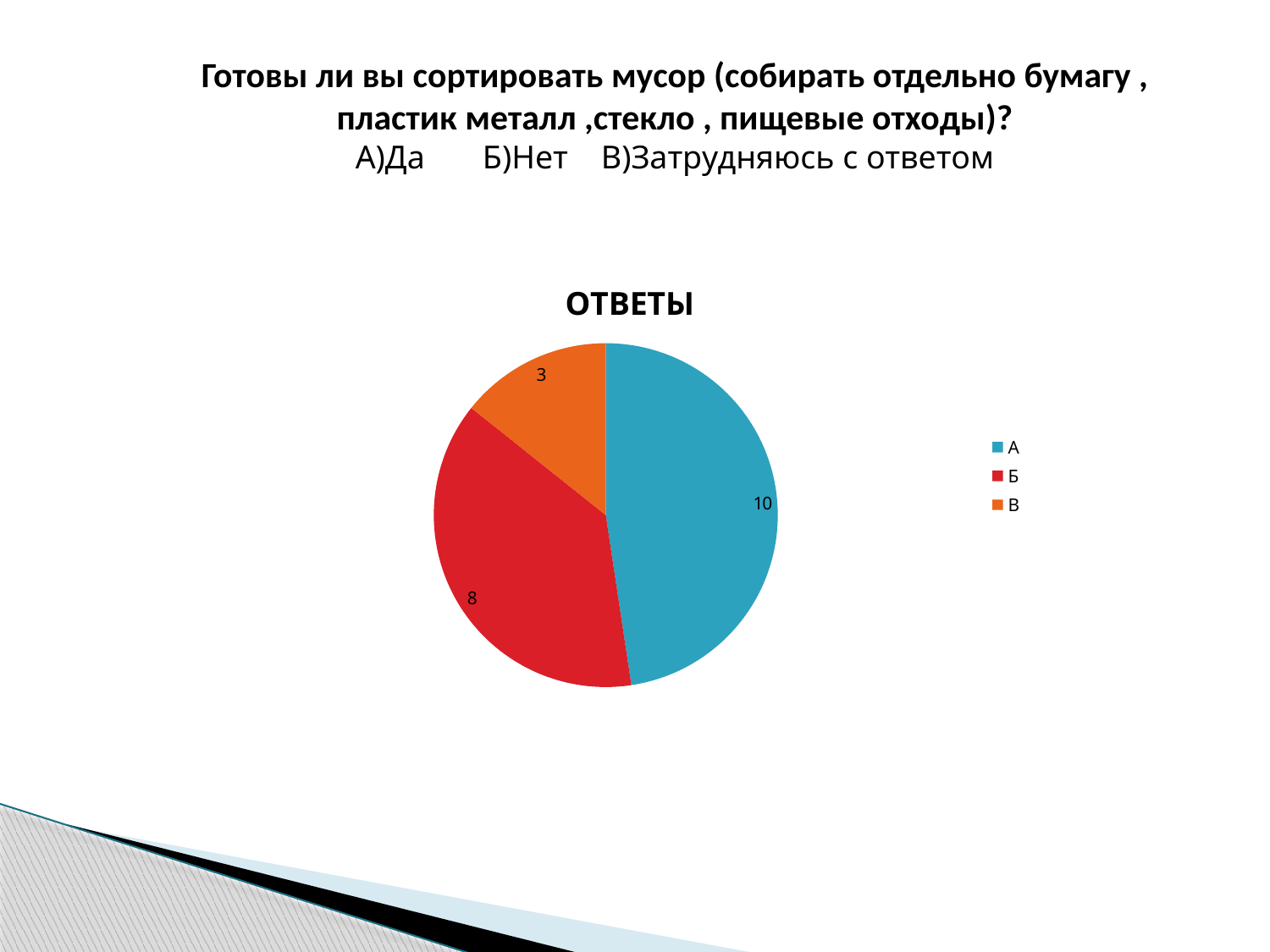
Which is larger, the value for Б or the value for В? Б What is the value for category А? 10 What is the difference between the values for Б and В? 5 What is the difference between the values for А and Б? 2 How many categories does the pie chart have? 3 What is the value for category В? 3 What is the value for category Б? 8 What is the title of the chart? ОТВЕТЫ What is the total of all slices in the pie chart? 21 What type of chart is shown on the slide? pie chart Which category has the largest slice? А Which category has the smallest slice? В